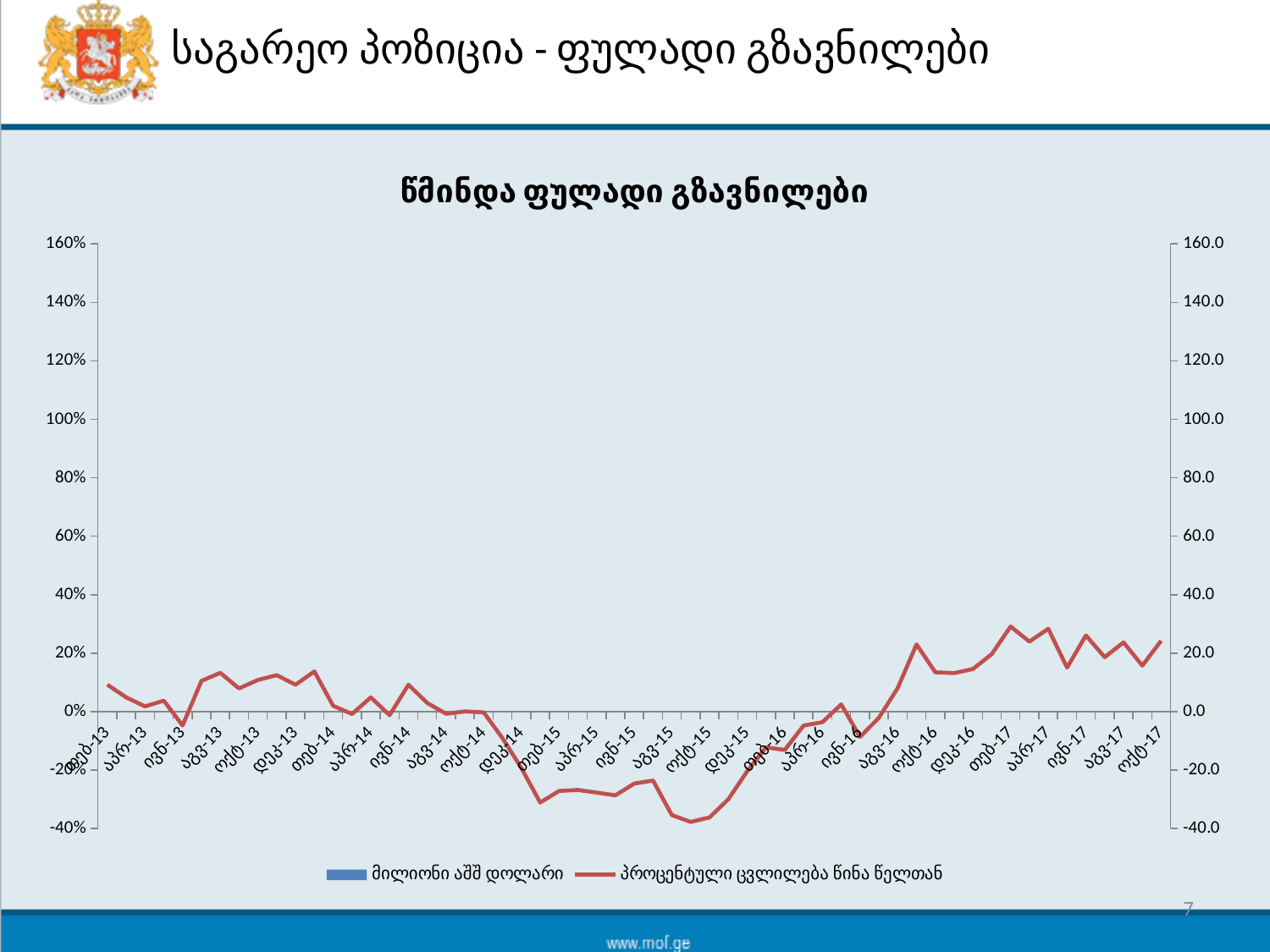
Is the value of პროცენტული ცვლილება წინა წელთან at აგვ-16 greater or less than 40%? less Which is larger, the value of პროცენტული ცვლილება წინა წელთან at ოქტ-17 or at ოქტ-15? ოქტ-17 What is the title of the chart? წმინდა ფულადი გზავნილები Is the value of პროცენტული ცვლილება წინა წელთან at ოქტ-15 greater or less than -20%? less What kind of chart is shown on the slide? line chart Does the პროცენტული ცვლილება წინა წელთან line rise or fall between აგვ-14 and დეკ-14? fall Does the პროცენტული ცვლილება წინა წელთან line rise or fall between დეკ-15 and თებ-17? rise Is the value of პროცენტული ცვლილება წინა წელთან at თებ-17 greater or less than 20%? greater How many series does the legend list? 2 What colour is the line for პროცენტული ცვლილება წინა წელთან? red